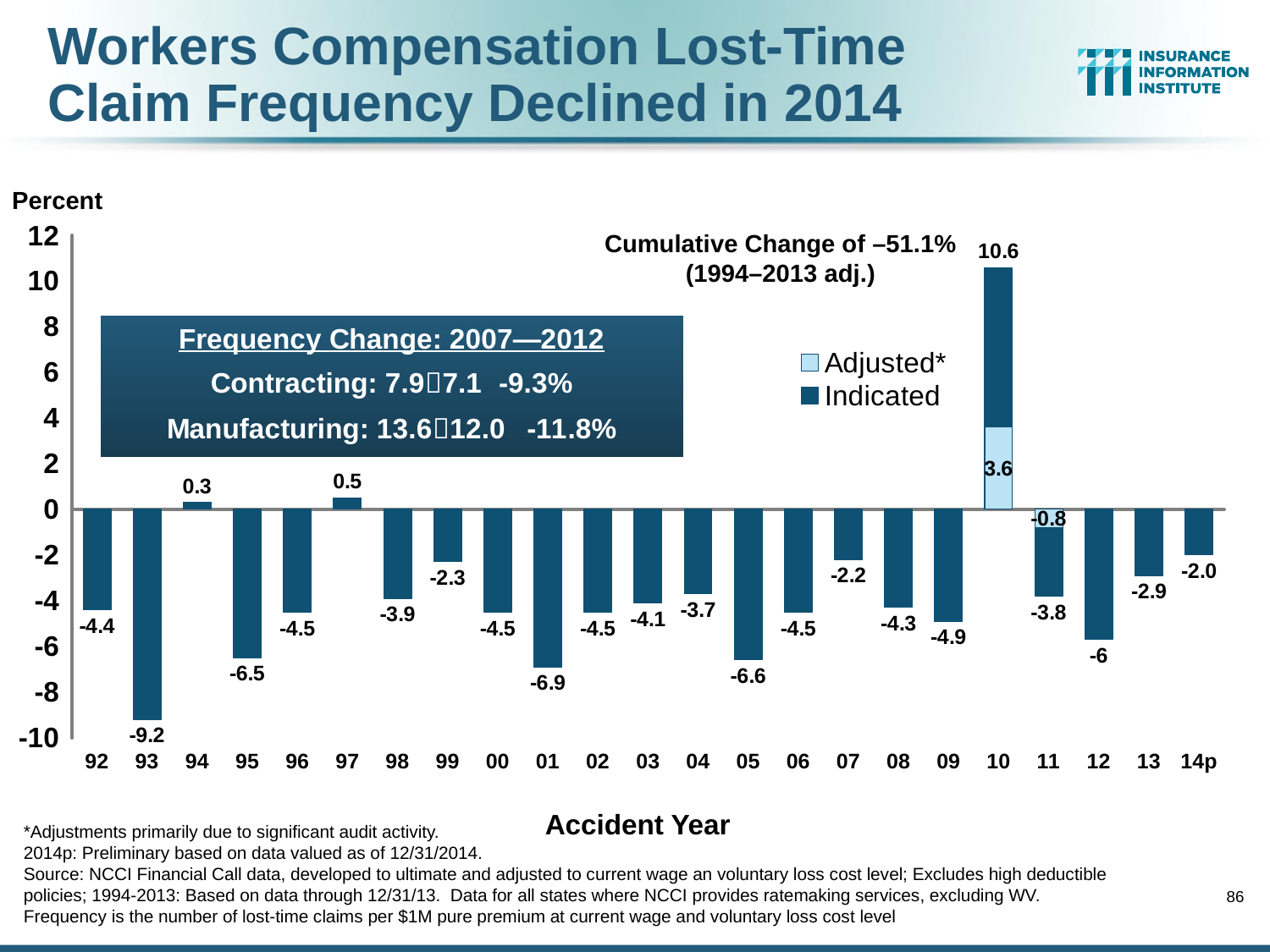
Which accident year has the highest indicated value? 10 Which accident year has a larger value, 94 or 97? 97 How many series does the legend list? 2 What is the value for accident year 14p? -2.0 What are the two series named in the legend? Adjusted* and Indicated What kind of chart is shown on the slide? Bar chart What is the difference between the values for accident years 12 and 13? 3.1 What is the indicated value for accident year 93? -9.2 Which accident year has the lowest value on the chart? 93 How many accident years are shown on the x axis? 23 What is the adjusted value for accident year 10? 3.6 What is the indicated value for accident year 10? 10.6